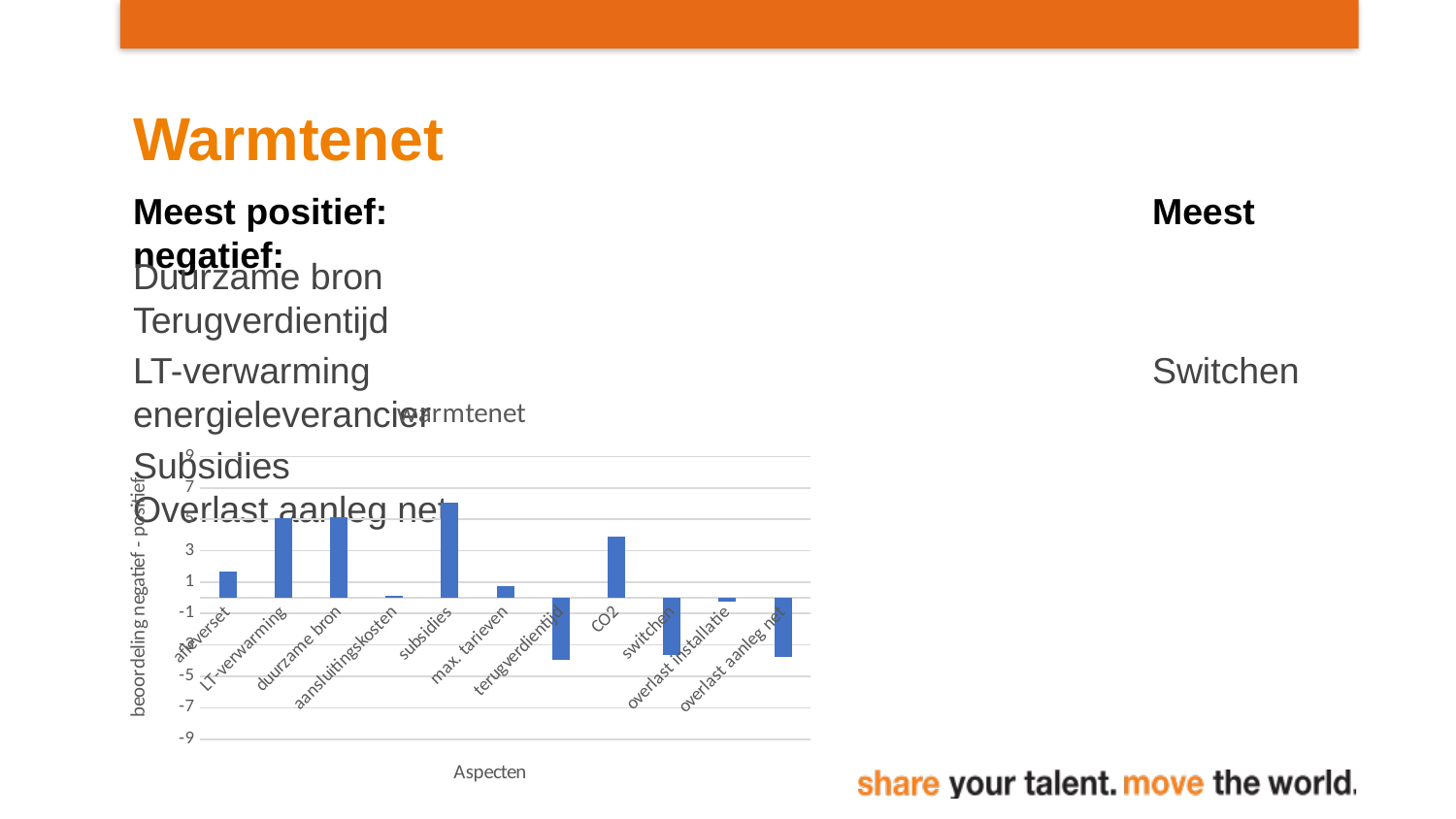
Which category has the highest value in the chart? subsidies Is the value for subsidies greater or less than 5? greater Which is larger, the value for LT-verwarming or the value for CO2? LT-verwarming What kind of chart is shown on the slide? bar chart What is the label of the x axis of the chart? Aspecten Is the value for terugverdientijd greater or less than -1? less What is the title of the chart? warmtenet Which is larger, the value for subsidies or the value for CO2? subsidies Is the value for CO2 greater or less than 5? less How many categories are plotted on the x axis of the chart? 11 Which is larger, the value for afleverset or the value for max. tarieven? afleverset